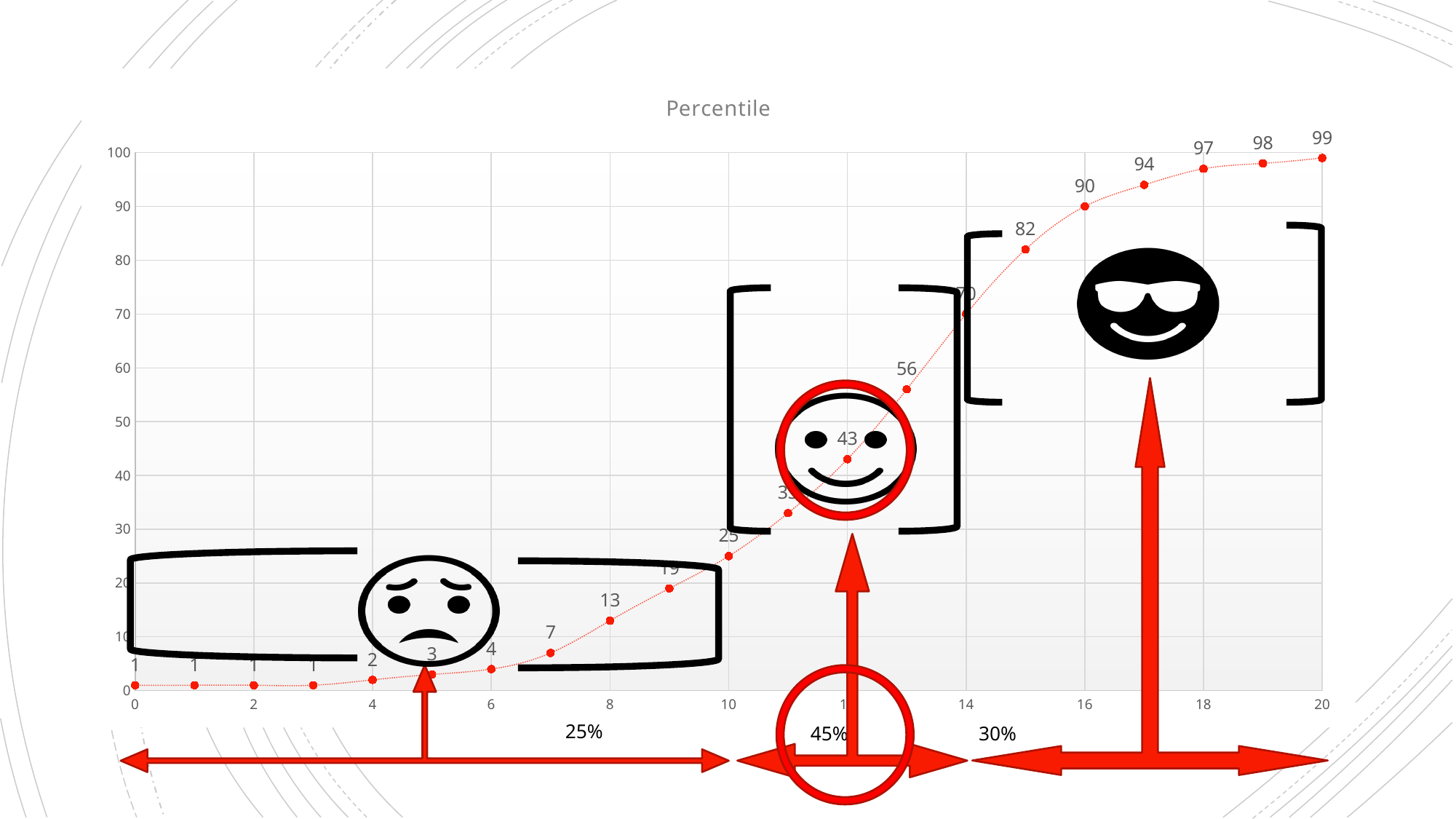
How many data points are plotted on the line? 21 What is the value plotted at x = 5? 3 What is the value plotted at x = 8? 13 Is the value at x = 14 greater or less than 60? greater What is the title of the chart? Percentile At which x value does the line reach its highest value? 20 What is the value plotted at x = 15? 82 What kind of chart is shown on the slide? line chart What is the value plotted at x = 20? 99 What is the difference between the values at x = 16 and x = 15? 8 Which is larger, the value at x = 13 or the value at x = 10? x = 13 Do the values rise or fall as x increases from 0 to 20? rise